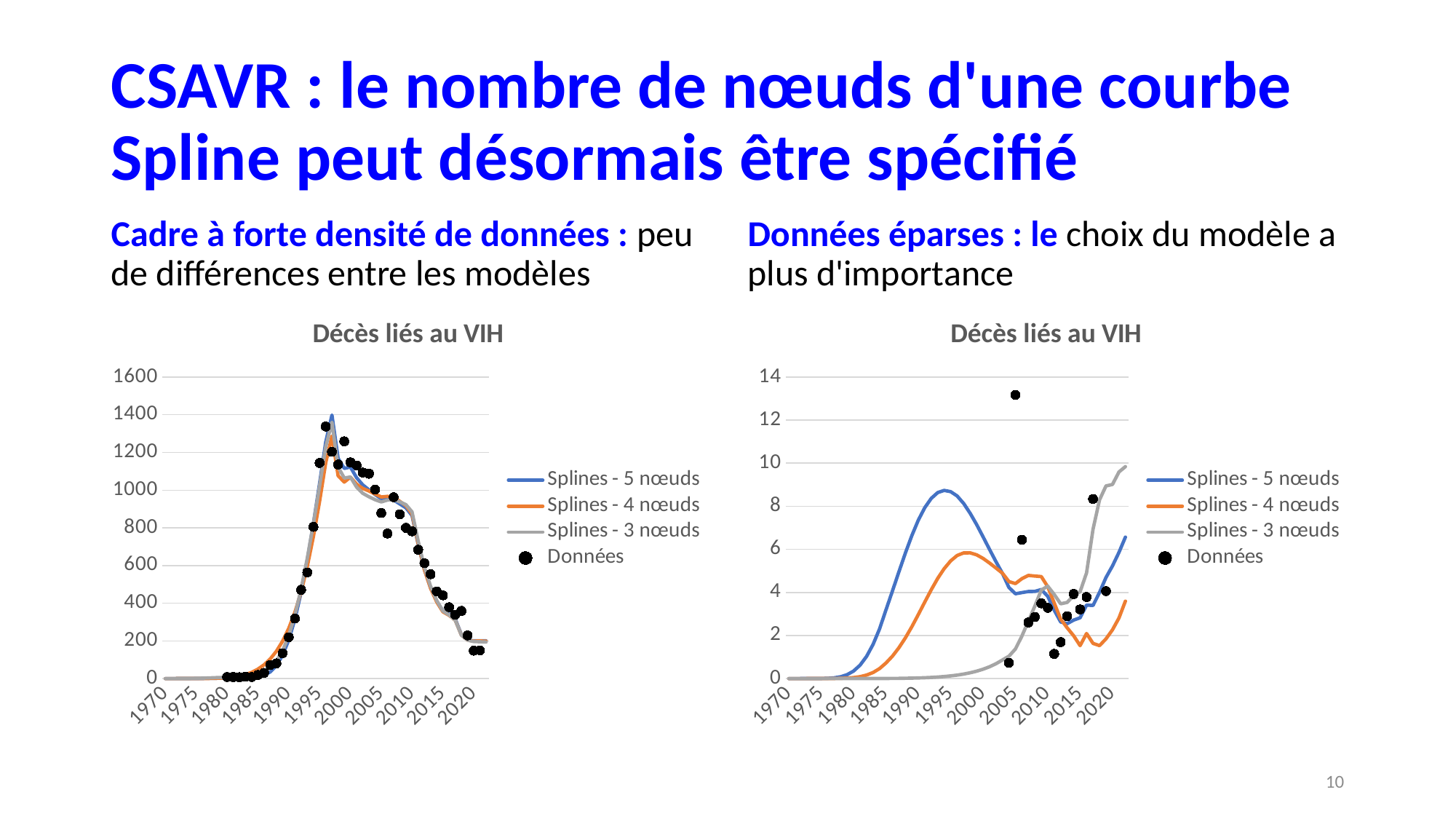
How many entries does the legend of the left chart list? 4 In the left chart, is the peak value of the Splines - 5 nœuds line greater or less than 1200? greater What kind of chart is the right chart? line chart In the right chart, which colour is used for the Splines - 4 nœuds series? orange In the right chart, is the peak value of the Splines - 4 nœuds line greater or less than 4? greater In the right chart, is the peak value of the Splines - 5 nœuds line greater or less than 8? greater What is the title of the chart on the left side of the slide? Décès liés au VIH In the left chart, do the spline lines rise or fall between 2000 and 2020? fall In the right chart, does the Splines - 5 nœuds line rise or fall between 1980 and 1995? rise